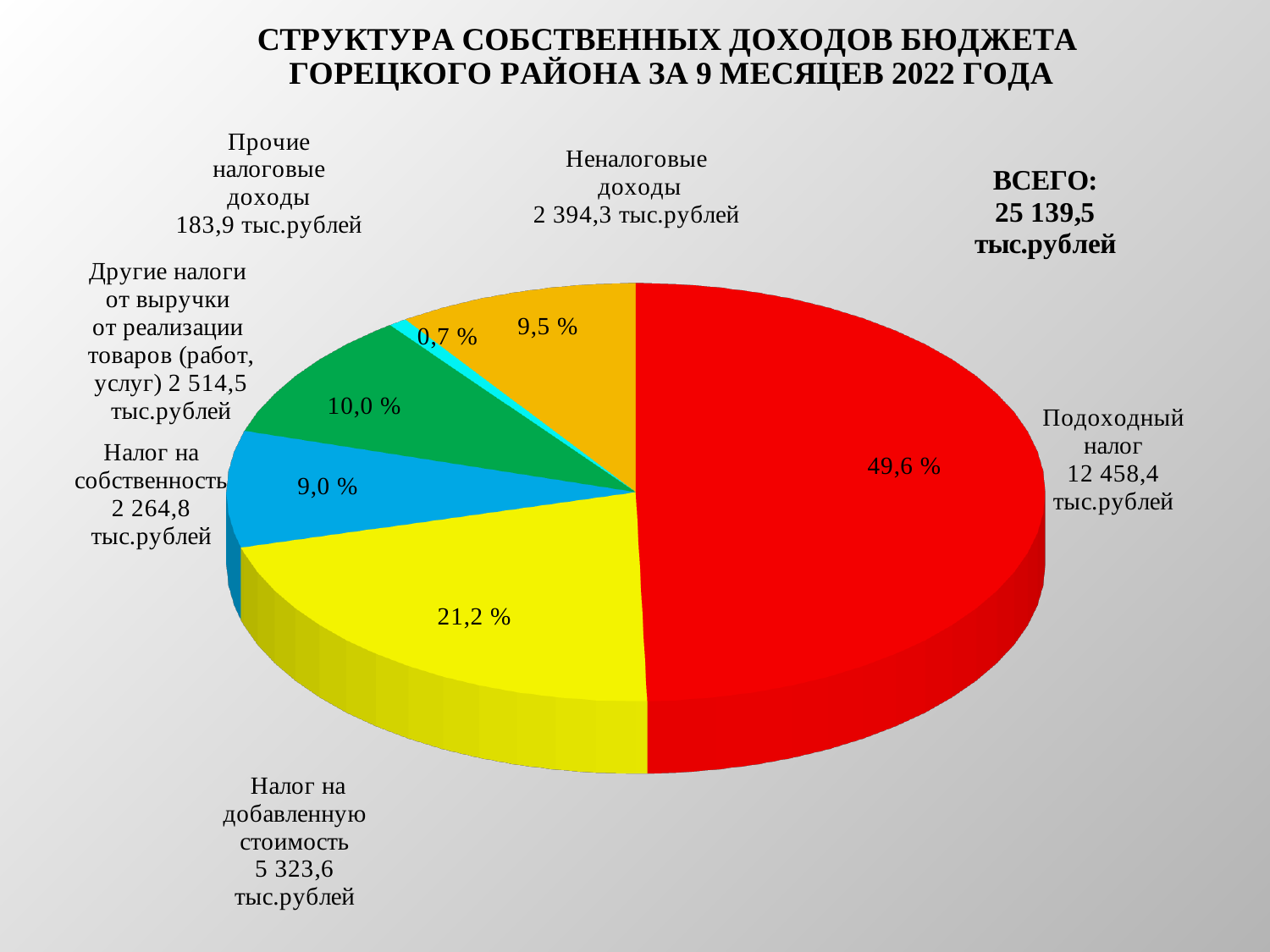
Which is larger: Налог на собственность or Другие налоги от выручки от реализации товаров (работ, услуг)? Другие налоги от выручки от реализации товаров (работ, услуг) What is the value shown for Неналоговые доходы? 2 394,3 тыс.рублей What is the value shown for Налог на собственность? 2 264,8 тыс.рублей What total (ВСЕГО) is shown on the slide? 25 139,5 тыс.рублей What share of the pie does Подоходный налог account for? 49,6 % How many slices does the pie chart have? 6 Which category has the largest slice of the pie? Подоходный налог What is the value shown for Прочие налоговые доходы? 183,9 тыс.рублей What type of chart is shown on the slide? pie chart Which category has the smallest slice of the pie? Прочие налоговые доходы What is the difference in percentage share between Подоходный налог and Налог на добавленную стоимость? 28,4 % What share of the pie does Налог на добавленную стоимость account for? 21,2 %